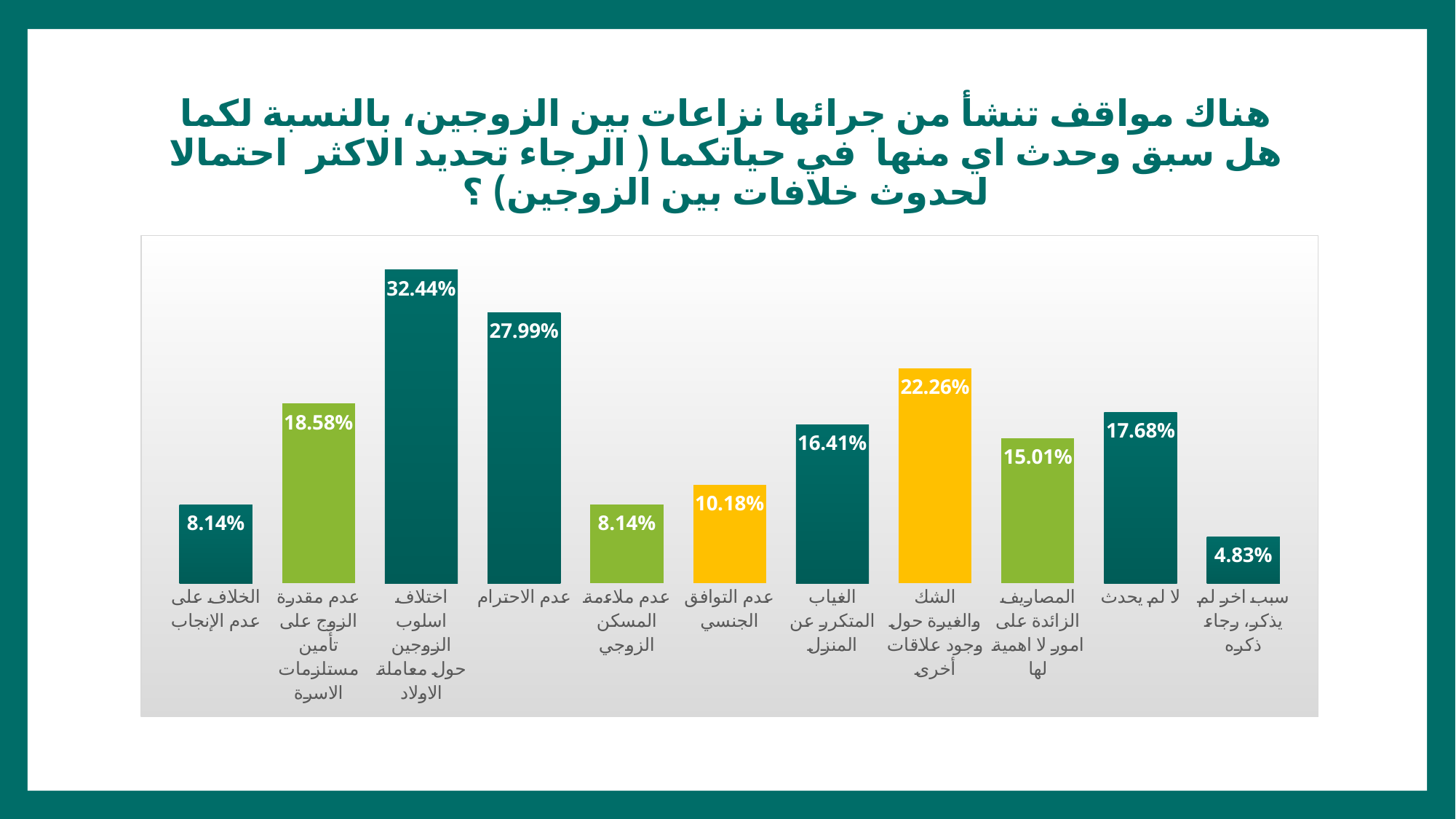
What kind of chart is shown on the slide? bar chart What is the difference between the values for الشك والغيرة حول وجود علاقات أخرى and المصاريف الزائدة على امور لا اهمية لها? 7.25% What is the value for الشك والغيرة حول وجود علاقات أخرى? 22.26% What is the value for عدم الاحترام? 27.99% What is the value for لا لم يحدث? 17.68% What is the value for عدم التوافق الجنسي? 10.18% Which category has the lowest value? سبب اخر لم يذكر، رجاء ذكره Which is larger: the value for عدم مقدرة الزوج على تأمين مستلزمات الاسرة or the value for الغياب المتكرر عن المنزل? عدم مقدرة الزوج على تأمين مستلزمات الاسرة What is the difference between the values for اختلاف اسلوب الزوجين حول معاملة الاولاد and عدم الاحترام? 4.45% What colour is the bar for عدم التوافق الجنسي? yellow Which category has the highest value? اختلاف اسلوب الزوجين حول معاملة الاولاد How many categories (bars) does the chart show? 11